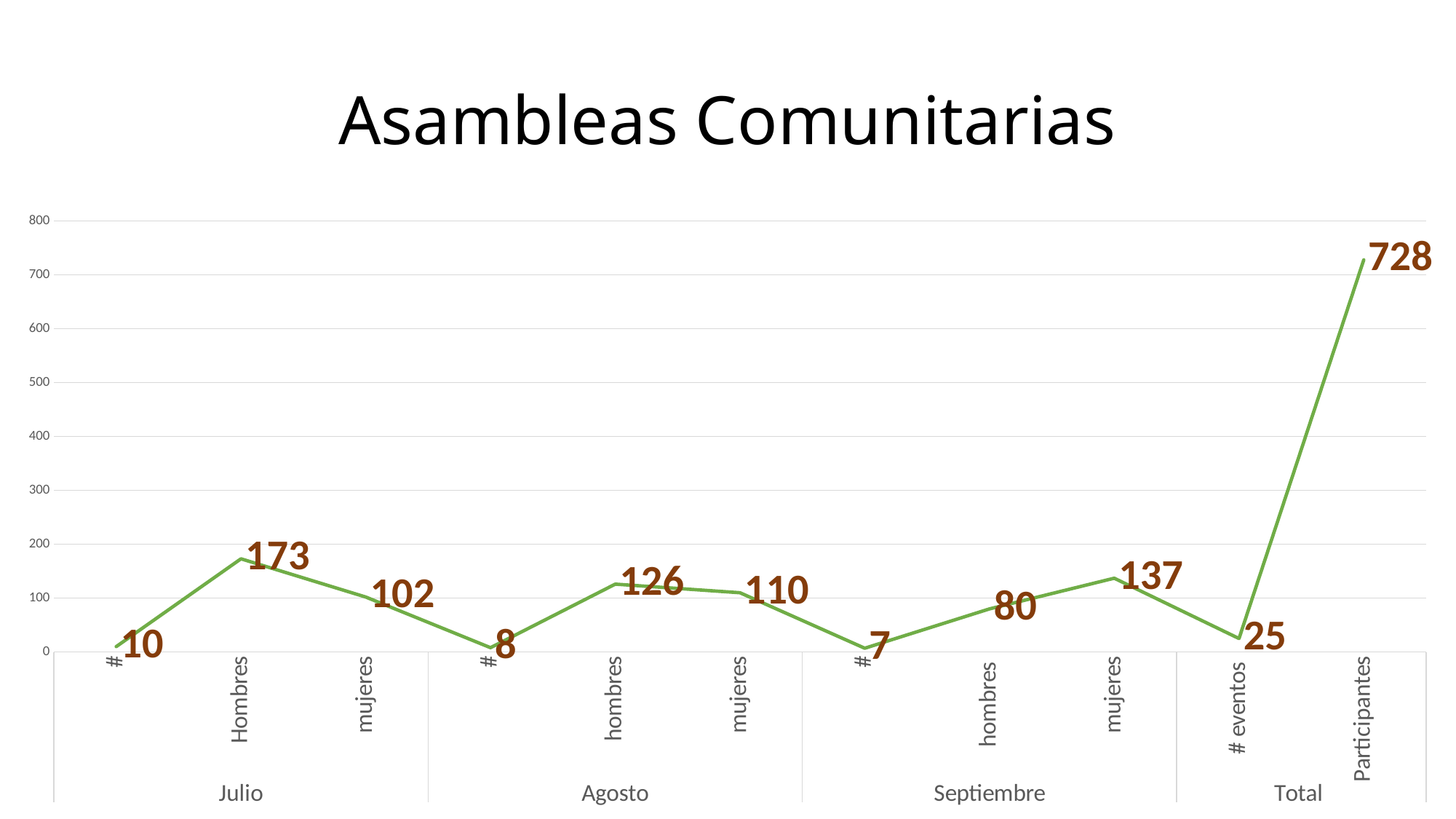
Which category has the highest value? Participantes Which is larger, mujeres in Septiembre or mujeres in Julio? mujeres in Septiembre What kind of chart is shown? line chart What is the title of the chart? Asambleas Comunitarias How many data points are plotted on the chart? 11 What is the value for mujeres in Agosto? 110 What is the value for hombres in Agosto? 126 What is the difference between Hombres in Julio and hombres in Septiembre? 93 Which category has the lowest value? # (Septiembre) What is the value for Hombres in Julio? 173 What is the value for Participantes under Total? 728 What is the value for # eventos under Total? 25